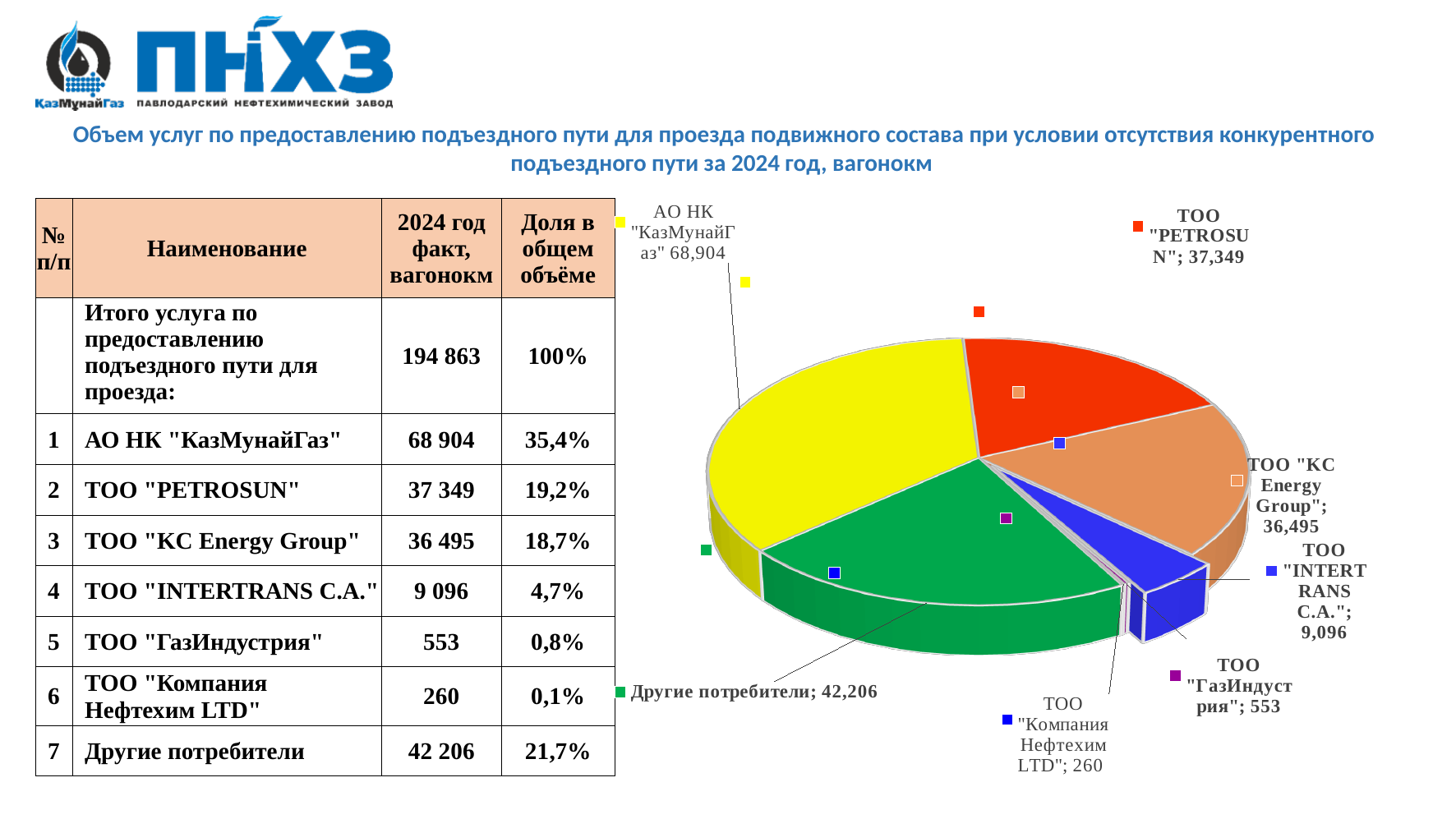
What is the value for Другие потребители in the pie chart? 42,206 What kind of chart is shown on the slide? pie chart What is the value for АО НК "КазМунайГаз" in the pie chart? 68,904 What is the value for ТОО "INTERTRANS C.A." in the pie chart? 9,096 What is the value for ТОО "KC Energy Group" in the pie chart? 36,495 Which slice of the pie chart has the smallest value? ТОО "Компания Нефтехим LTD" What is the value for ТОО "PETROSUN" in the pie chart? 37,349 How many slices does the pie chart have? 7 Which is larger in the pie chart: Другие потребители or ТОО "PETROSUN"? Другие потребители Which slice of the pie chart has the largest value? АО НК "КазМунайГаз" What is the difference between the values for ТОО "PETROSUN" and ТОО "KC Energy Group" in the pie chart? 854 What is the value for ТОО "ГазИндустрия" in the pie chart? 553